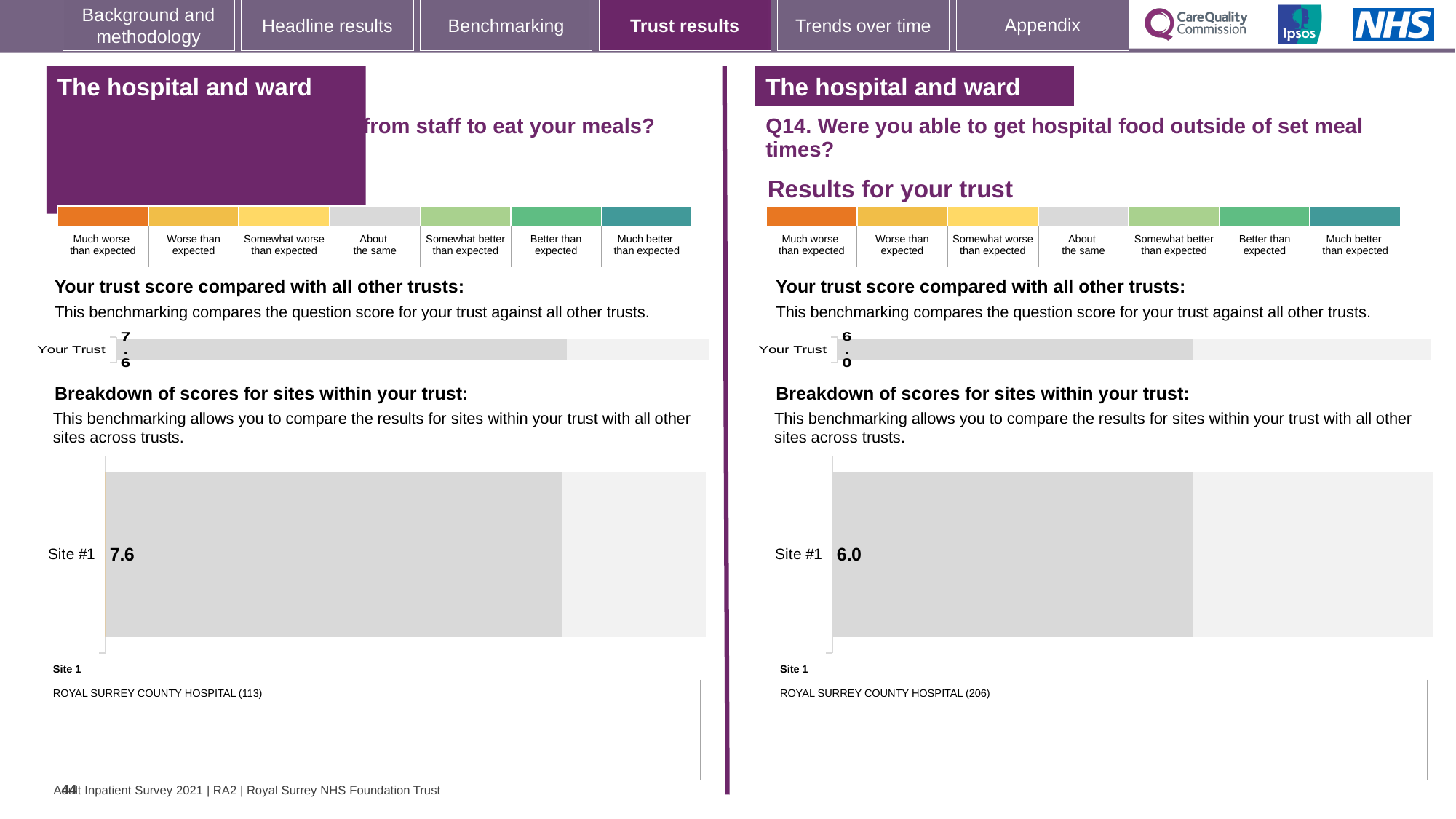
What type of chart is used to show the Site #1 score on the Q14 chart? Bar chart Which Site #1 score is larger: the one on the left-hand chart or the one on the Q14 chart on the right? The left-hand chart (7.6) How many categories does the colour scale above the Q14 chart show, from 'Much worse than expected' to 'Much better than expected'? 7 In the left-hand breakdown of scores for sites within your trust, what is the score for Site #1? 7.6 On the Q14 chart, which hospital is listed as Site 1? ROYAL SURREY COUNTY HOSPITAL (206) Which Your Trust score is larger: the left-hand chart or the Q14 chart on the right? The left-hand chart (7.6) On the left-hand chart (help from staff to eat your meals), what is the score shown for Your Trust? 7.6 In the Q14 breakdown of scores for sites within your trust, what is the score for Site #1? 6.0 How many sites are shown in the left-hand breakdown of scores for sites within your trust? 1 How many sites are shown in the Q14 breakdown of scores for sites within your trust? 1 On the right-hand chart for Q14 (hospital food outside of set meal times), what is the score shown for Your Trust? 6.0 What is the difference between the Site #1 score on the left-hand chart and the Site #1 score on the Q14 chart? 1.6